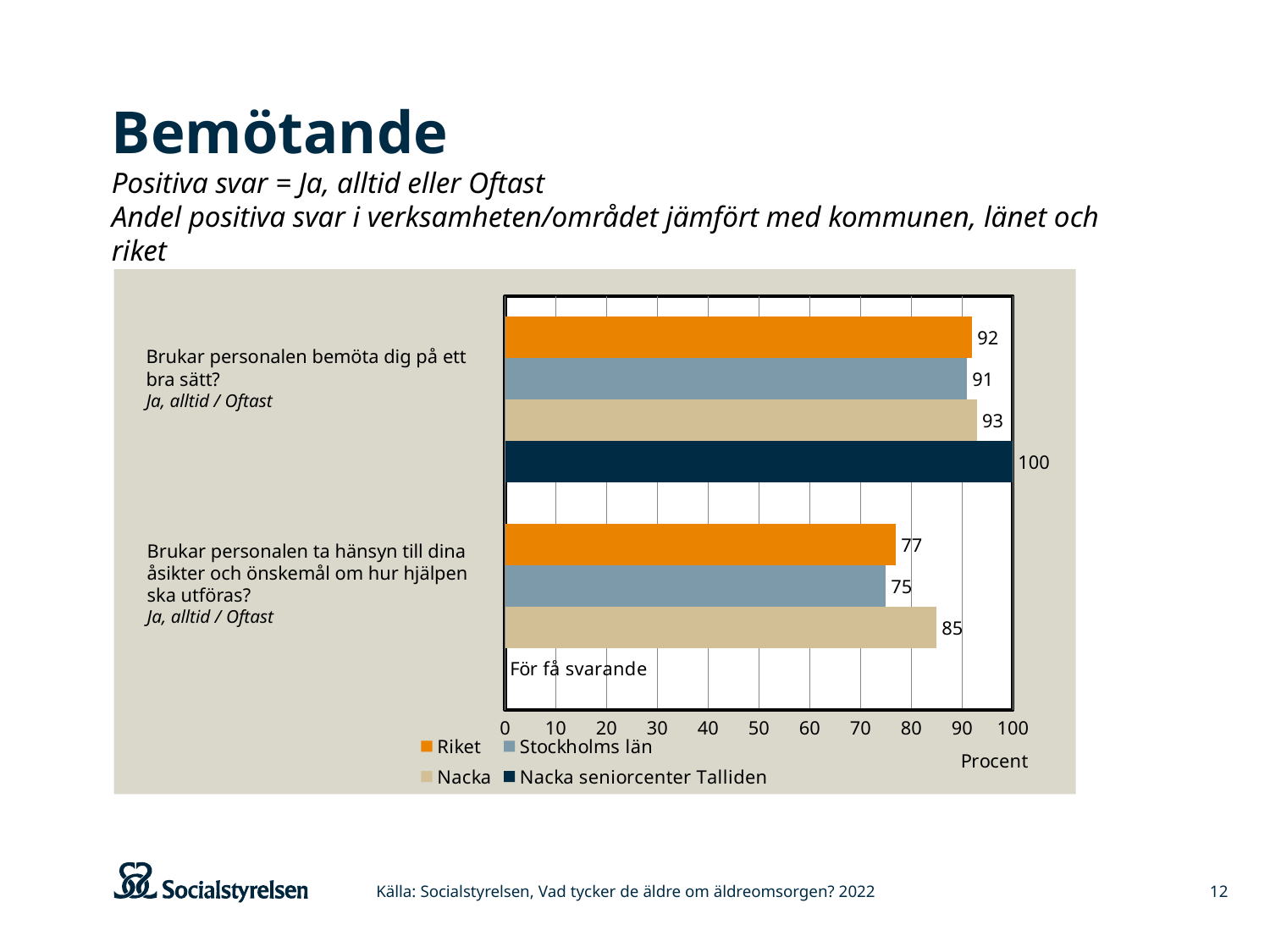
What is the label of the horizontal axis? Procent Which is larger on the question "Brukar personalen bemöta dig på ett bra sätt?": Nacka or Stockholms län? Nacka What value is shown for Nacka seniorcenter Talliden on the question "Brukar personalen bemöta dig på ett bra sätt?"? 100 What is shown instead of a bar for Nacka seniorcenter Talliden on the question "Brukar personalen ta hänsyn till dina åsikter och önskemål om hur hjälpen ska utföras?"? För få svarande What is the difference between Nacka and Riket on the question "Brukar personalen ta hänsyn till dina åsikter och önskemål om hur hjälpen ska utföras?"? 8 How many series does the legend list? 4 Which series has the lowest value on the question "Brukar personalen ta hänsyn till dina åsikter och önskemål om hur hjälpen ska utföras?"? Stockholms län Which series has the highest value on the question "Brukar personalen bemöta dig på ett bra sätt?"? Nacka seniorcenter Talliden What kind of chart is shown on the slide? Bar chart What value is shown for Nacka on the question "Brukar personalen ta hänsyn till dina åsikter och önskemål om hur hjälpen ska utföras?"? 85 What value is shown for Riket on the question "Brukar personalen bemöta dig på ett bra sätt?"? 92 What value is shown for Stockholms län on the question "Brukar personalen ta hänsyn till dina åsikter och önskemål om hur hjälpen ska utföras?"? 75